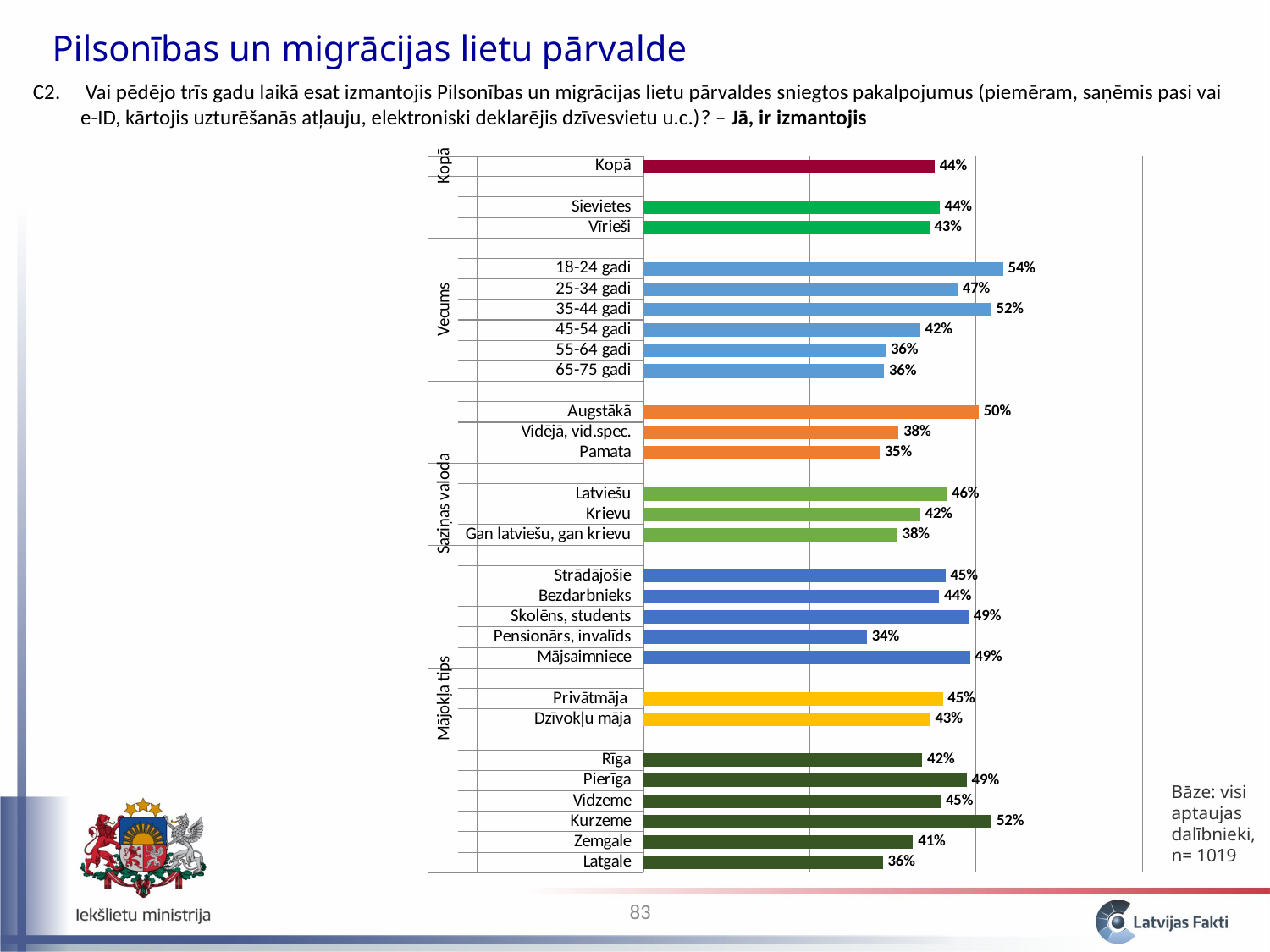
What is the difference between the values for Pierīga and Latgale? 13% How many categories (bars) are plotted in the chart? 28 What is the value for Kurzeme? 52% What is the value for 18-24 gadi? 54% Which category has the lowest value in the chart? Pensionārs, invalīds What is the difference between the values for Augstākā and Pamata? 15% Which has a larger value, Latviešu or Krievu? Latviešu What kind of chart is shown on the slide? bar chart What is the value for Kopā? 44% What is the value for Pensionārs, invalīds? 34% Which has a larger value, Sievietes or Vīrieši? Sievietes Which category has the highest value in the chart? 18-24 gadi